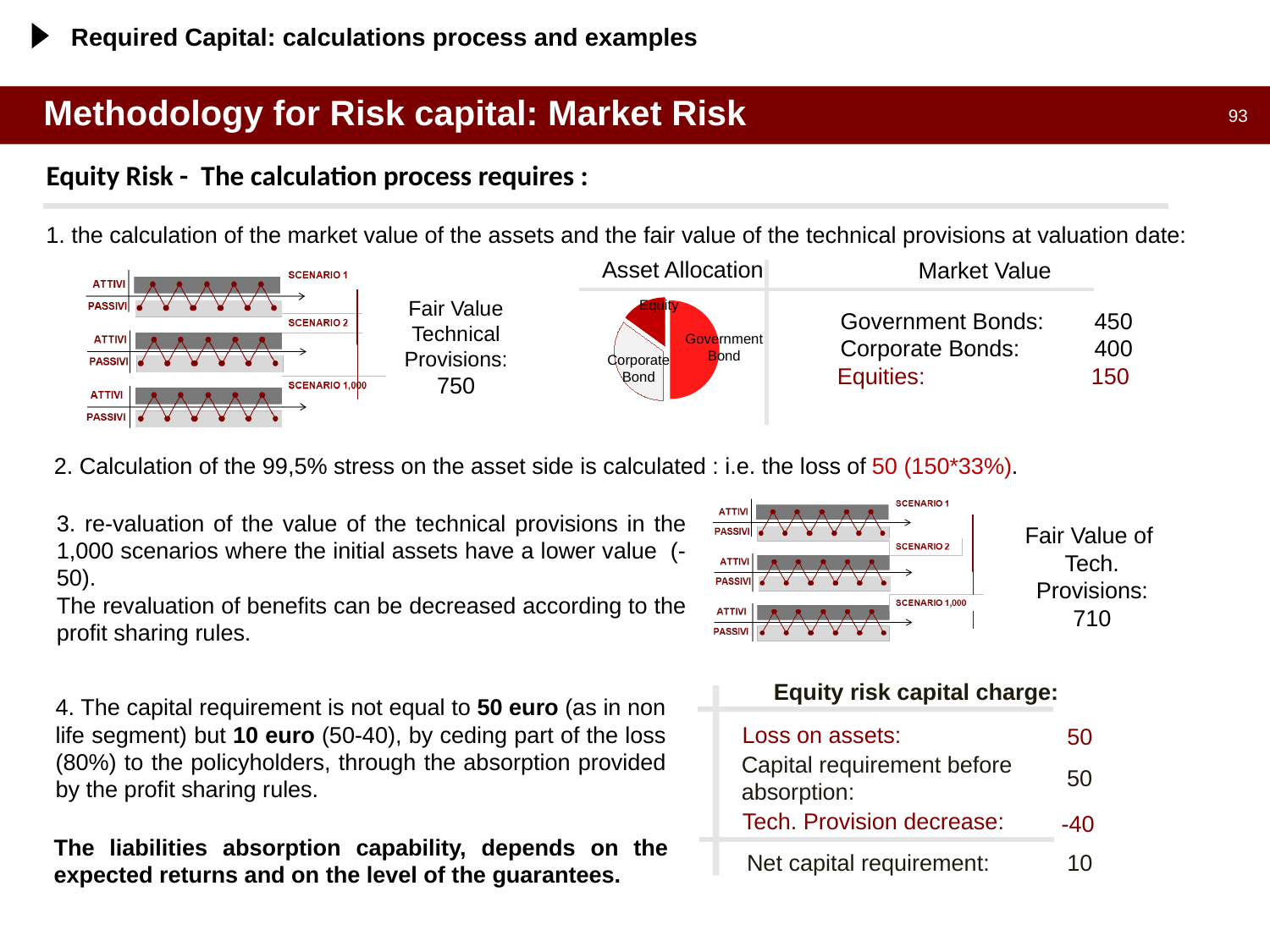
Which slice is the smallest in the Asset Allocation pie chart? Equity What kind of chart is the Asset Allocation chart? pie chart What colour is the Government Bond slice in the Asset Allocation pie chart? red In the Asset Allocation pie chart, which slice is larger: Corporate Bond or Equity? Corporate Bond How many slices does the Asset Allocation pie chart have? 3 In the Asset Allocation pie chart, which slice is larger: Government Bond or Equity? Government Bond What is the title of the pie chart on the slide? Asset Allocation Which slice is the largest in the Asset Allocation pie chart? Government Bond